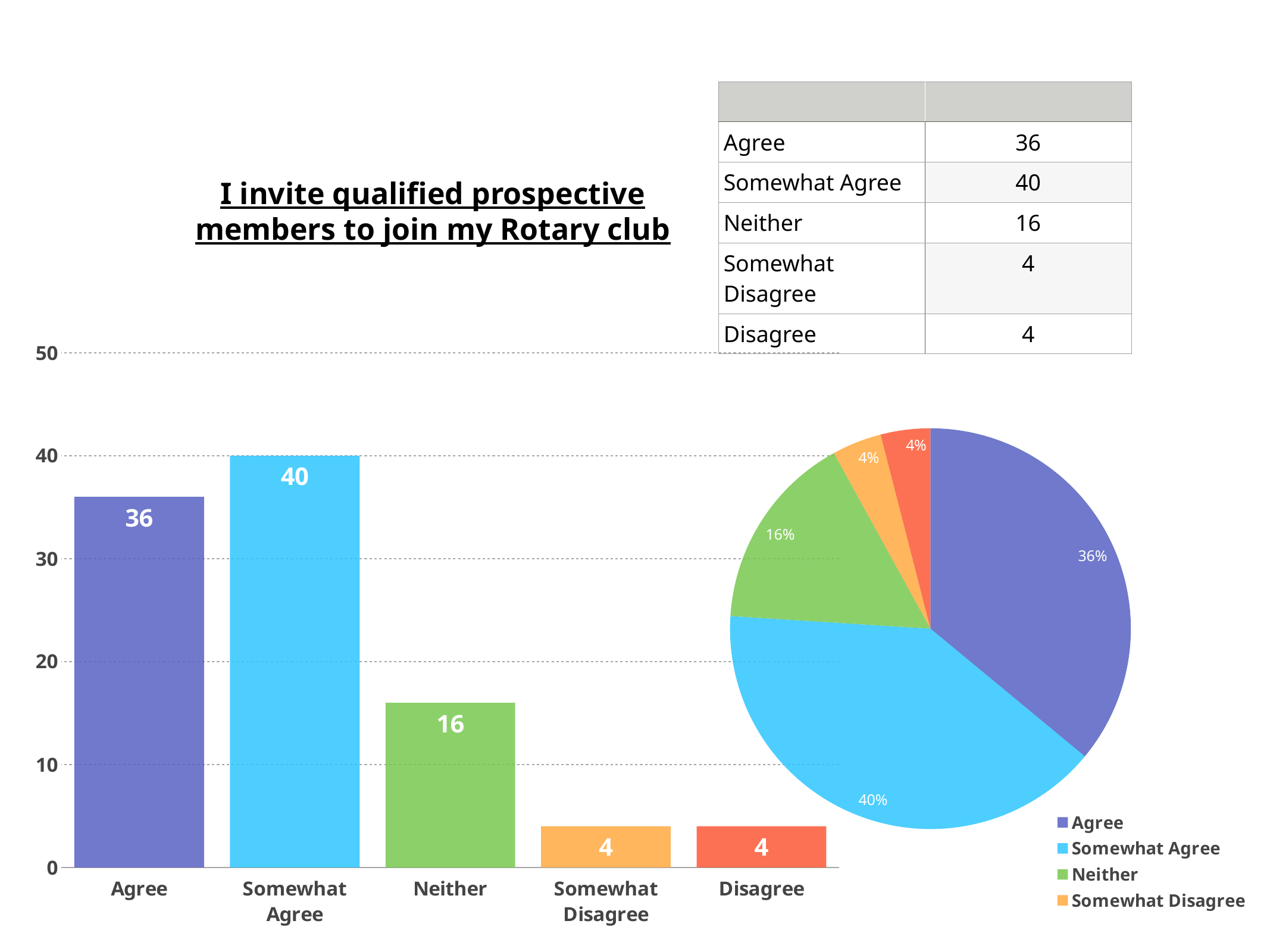
In the bar chart on the left, what is the difference between the values for Somewhat Agree and Agree? 4 In the bar chart on the left, what is the value for Neither? 16 In the pie chart on the right, what share does the Somewhat Agree slice have? 40% What kind of chart is the chart on the left of the slide? bar chart How many categories are shown in the bar chart on the left? 5 What is the title shown above the charts on the slide? I invite qualified prospective members to join my Rotary club In the bar chart on the left, what is the value for Somewhat Agree? 40 In the pie chart on the right, what share does the Neither slice have? 16% In the bar chart on the left, is the value for Neither greater or less than 20? less In the bar chart on the left, what is the difference between the values for Neither and Disagree? 12 In the bar chart on the left, which is larger, the value for Agree or the value for Neither? Agree In the bar chart on the left, which category has the highest value? Somewhat Agree